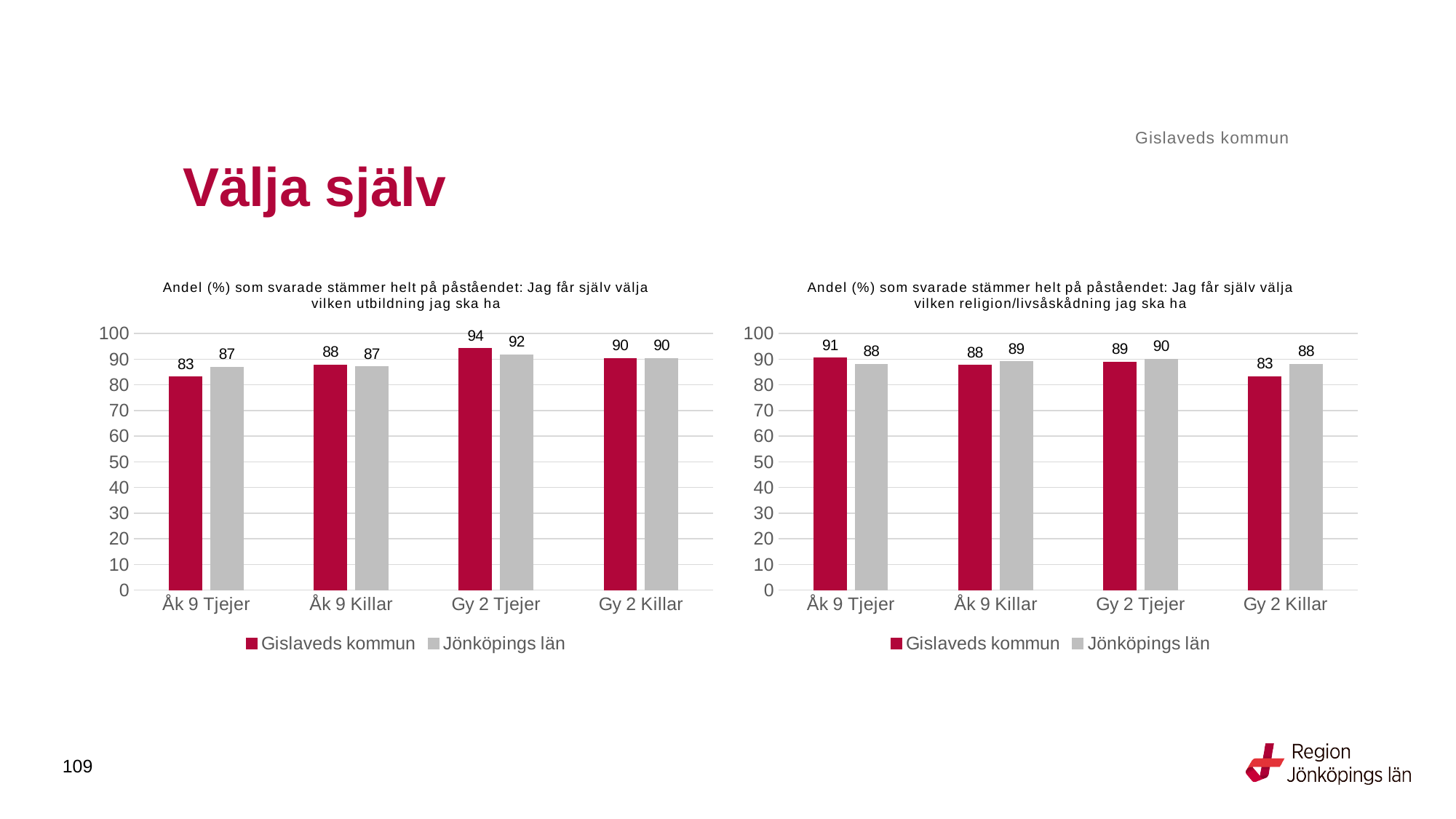
How many series does the legend of the left chart list? 2 In the left chart (about choosing education), how many categories are shown on the x axis? 4 In the right chart (about choosing religion), what is the value for Gislaveds kommun for Åk 9 Tjejer? 91 In the left chart (about choosing education), what is the value for Jönköpings län for Gy 2 Tjejer? 92 What kind of chart is the right chart (about choosing religion)? Bar chart In the left chart (about choosing education), which category has the highest value for Gislaveds kommun? Gy 2 Tjejer In the right chart (about choosing religion), which category has the lowest value for Gislaveds kommun? Gy 2 Killar In the left chart (about choosing education), what is the difference between Gislaveds kommun and Jönköpings län for Åk 9 Tjejer? 4 In the right chart (about choosing religion), what is the difference between Jönköpings län and Gislaveds kommun for Gy 2 Killar? 5 In the right chart (about choosing religion), what is the value for Jönköpings län for Gy 2 Killar? 88 In the right chart (about choosing religion), which is larger for Gy 2 Killar: Gislaveds kommun or Jönköpings län? Jönköpings län In the left chart (about choosing education), what is the value for Gislaveds kommun for Åk 9 Tjejer? 83